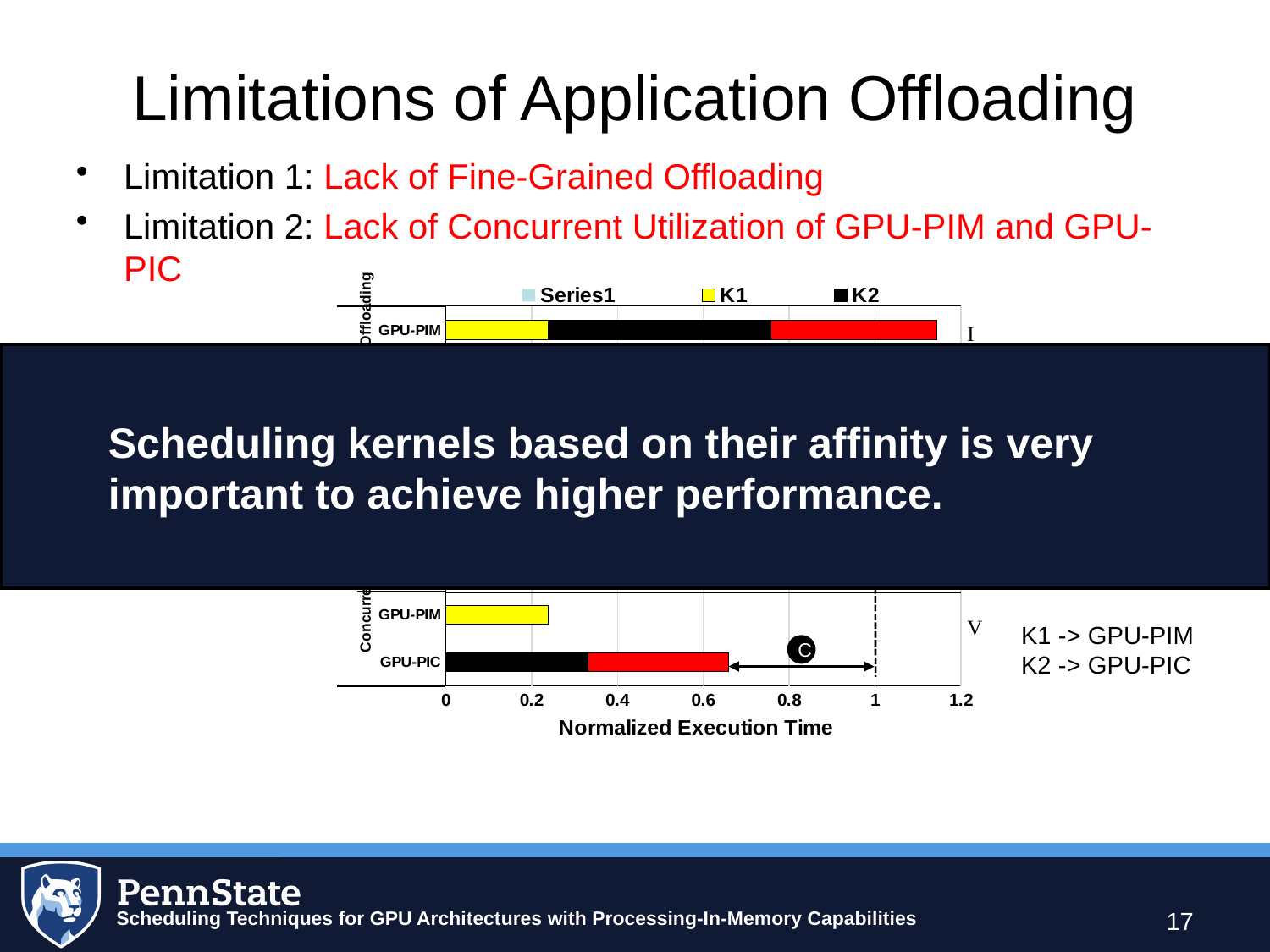
Is the total length of the Concurrent GPU-PIM bar greater or less than 0.4? less In the Concurrent section, which bar is longer: GPU-PIM or GPU-PIC? GPU-PIC Is the total length of the Concurrent GPU-PIC bar greater or less than 0.4? greater Which colour represents the K1 series in the chart? yellow Which bar is longer: the Offloading GPU-PIM bar or the Concurrent GPU-PIC bar? Offloading GPU-PIM At what x-axis value is the vertical dashed line drawn in the chart? 1 How many series does the chart legend list? 3 Is the total length of the Offloading GPU-PIM bar greater or less than 1? greater What kind of chart is shown on the slide? bar chart What is the title of the x axis of the chart? Normalized Execution Time What is the largest tick value shown on the x axis of the chart? 1.2